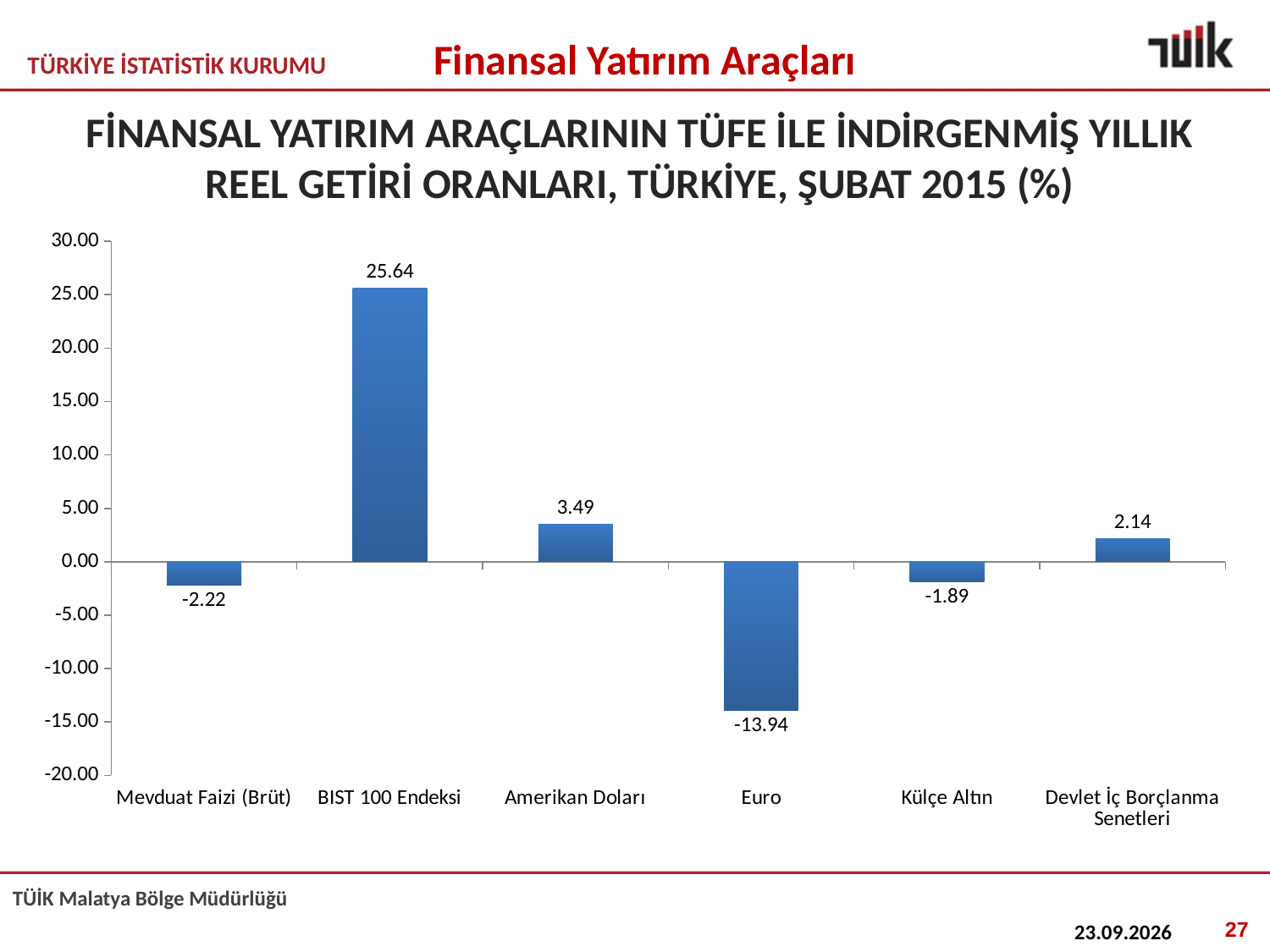
Which category has the lowest value? Euro What is the value for Euro? -13.94 What kind of chart is shown on the slide? bar chart Which is larger, the value for Amerikan Doları or the value for Devlet İç Borçlanma Senetleri? Amerikan Doları Is the value for Euro greater or less than -10.00? less Which category has the highest value? BIST 100 Endeksi What is the value for BIST 100 Endeksi? 25.64 How many categories have negative values? 3 How many categories are shown on the x axis? 6 What is the value for Devlet İç Borçlanma Senetleri? 2.14 What is the difference between the values for BIST 100 Endeksi and Amerikan Doları? 22.15 What is the value for Külçe Altın? -1.89